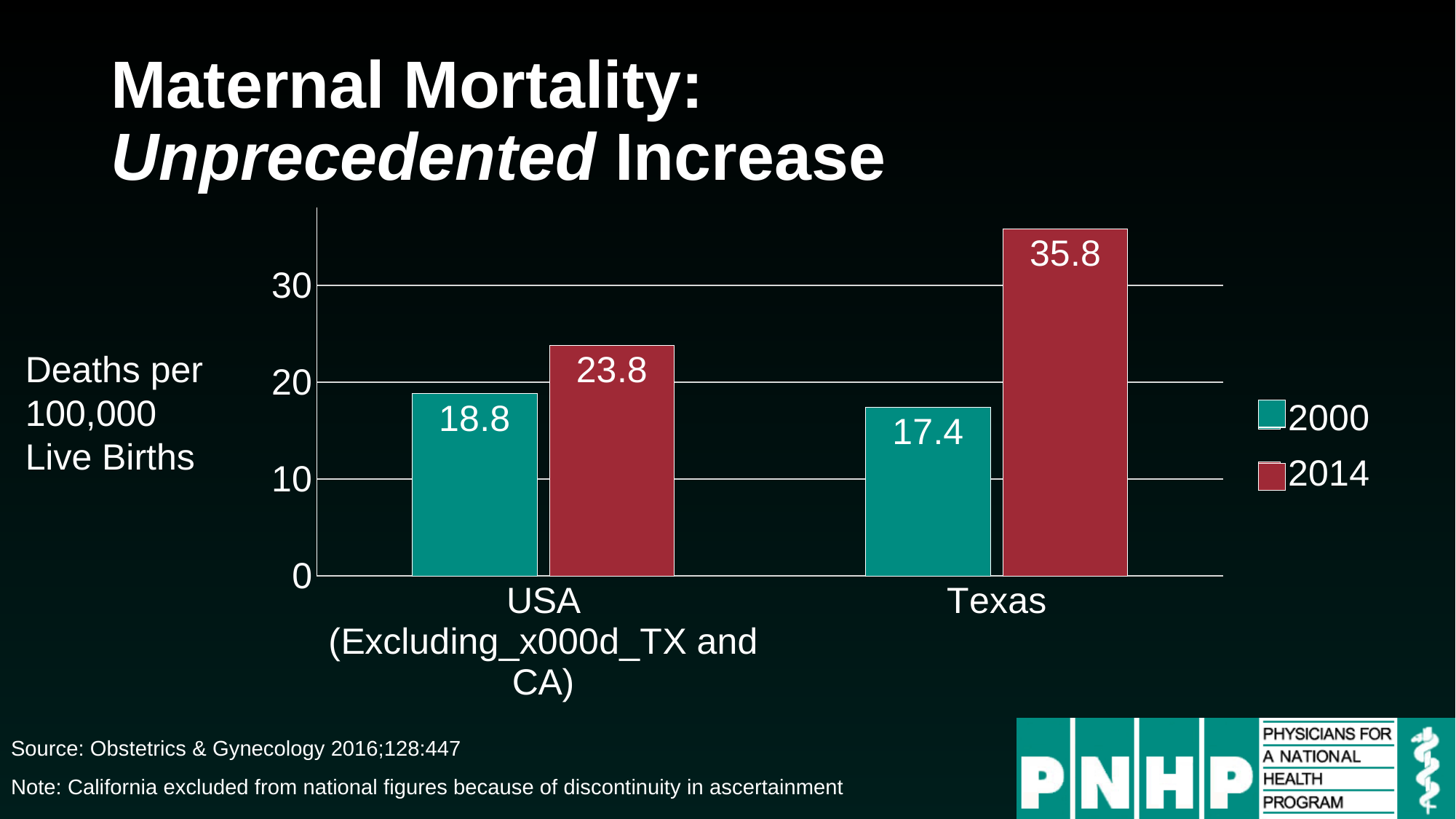
What is the difference between the 2014 and 2000 values for Texas? 18.4 What is the maternal mortality value for the USA (excluding TX and CA) in 2014? 23.8 What is the difference between the 2014 and 2000 values for the USA (excluding TX and CA)? 5.0 Which bar has the highest value on the chart? Texas, 2014 Which bar has the lowest value on the chart? Texas, 2000 What unit is the y axis measured in, according to the label on the slide? Deaths per 100,000 Live Births What kind of chart is shown on the slide? Bar chart Which is larger: the 2000 value for the USA (excluding TX and CA) or the 2000 value for Texas? USA (excluding TX and CA) What is the maternal mortality value for Texas in 2000? 17.4 How many series does the legend list? 2 What is the maternal mortality value for Texas in 2014? 35.8 What is the maternal mortality value for the USA (excluding TX and CA) in 2000? 18.8